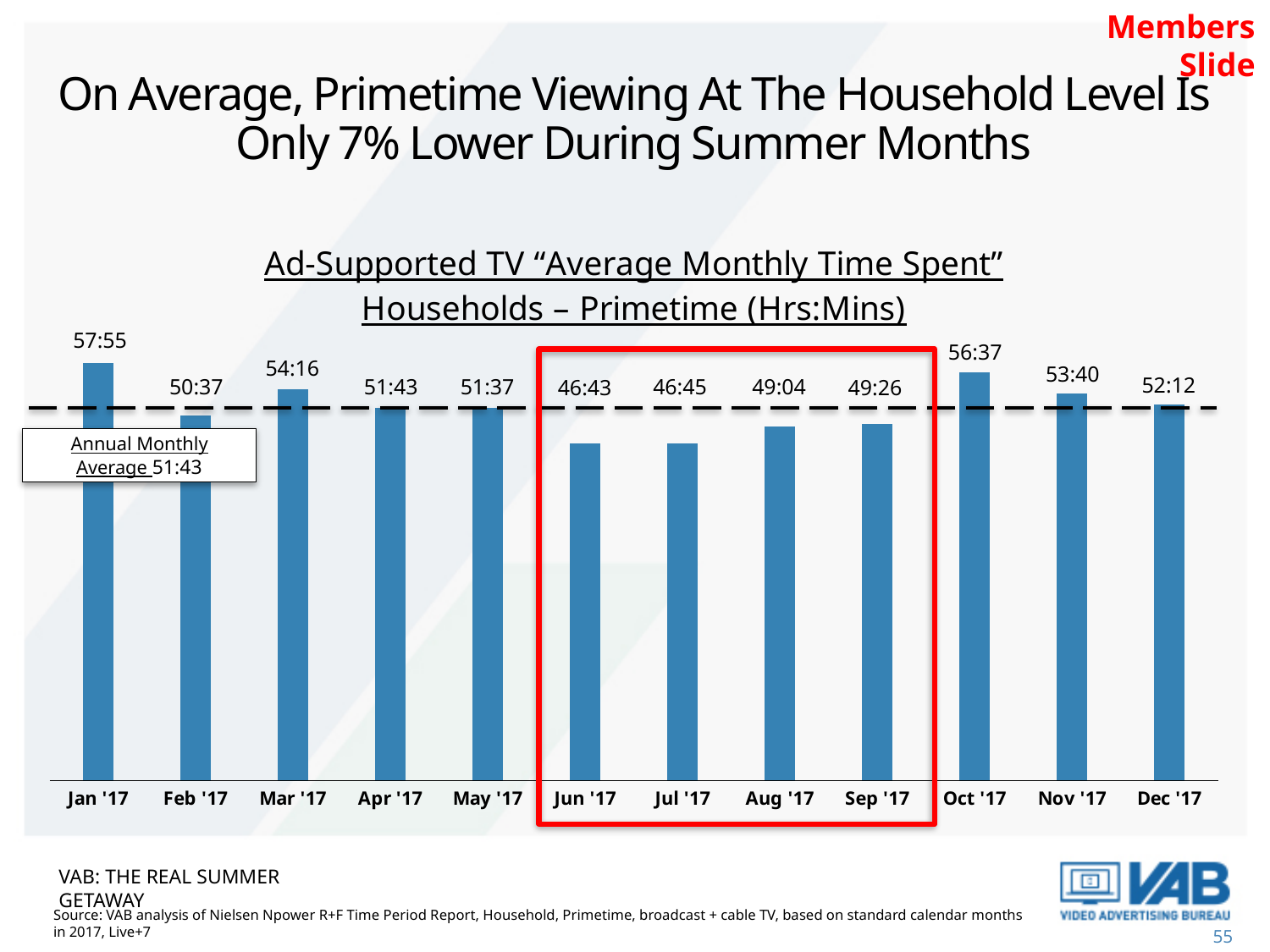
Which month has the lowest average monthly time spent? Jun '17 What is the value shown for Oct '17? 56:37 Do the values rise or fall from Jun '17 to Sep '17? Rise What annual monthly average is indicated by the dashed line? 51:43 What is the value shown for Aug '17? 49:04 Which is larger, the value for Mar '17 or the value for Nov '17? Mar '17 Which month has the highest average monthly time spent? Jan '17 What is the difference between the Oct '17 and Sep '17 values? 7:11 How many months are plotted on the chart? 12 What kind of chart is shown on the slide? Bar chart What is the difference between the Jan '17 and Jun '17 values? 11:12 What is the average monthly time spent for Jan '17? 57:55